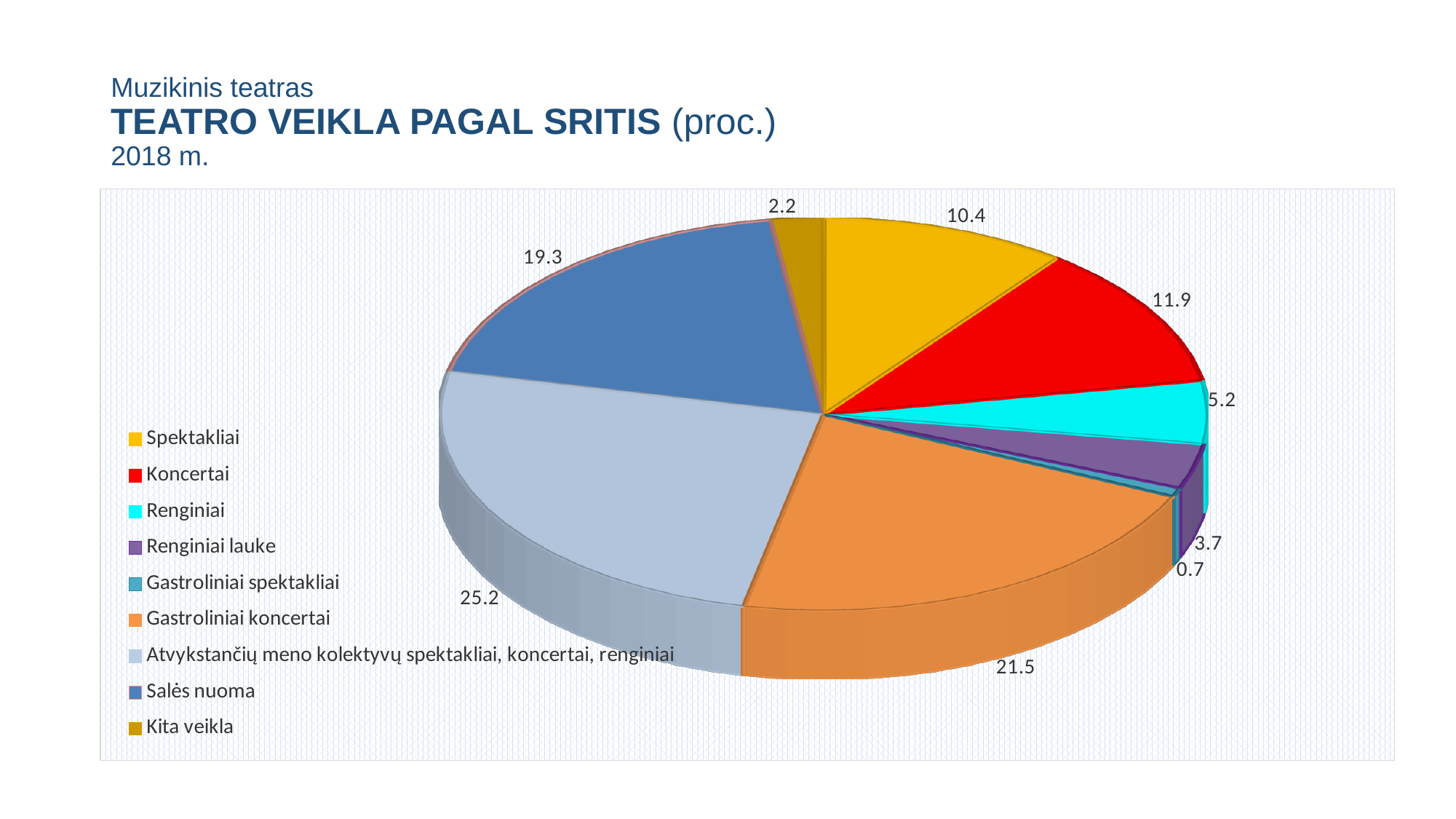
What kind of chart is shown on the slide? pie chart What is the value for Gastroliniai koncertai? 21.5 What colour is the slice for Renginiai? cyan What is the value for Koncertai? 11.9 What is the value for Spektakliai? 10.4 Which is larger, the value for Koncertai or the value for Spektakliai? Koncertai Which category has the largest share of the pie? Atvykstančių meno kolektyvų spektakliai, koncertai, renginiai What is the difference between the values for Gastroliniai koncertai and Salės nuoma? 2.2 What is the value for Gastroliniai spektakliai? 0.7 How many categories does the pie chart have? 9 What is the value for Salės nuoma? 19.3 Which category has the smallest share of the pie? Gastroliniai spektakliai